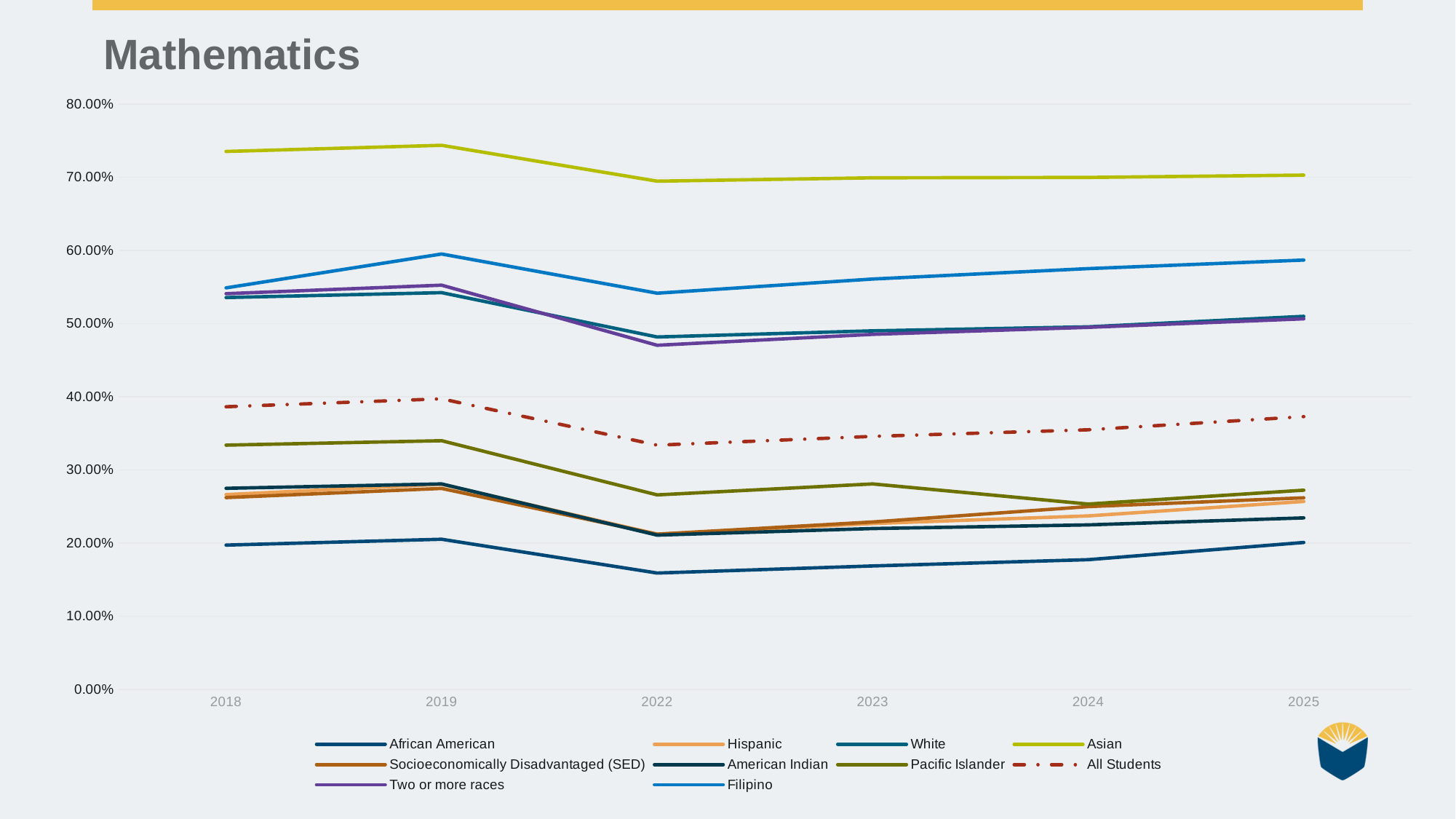
Is the value for African American in 2022 greater or less than 20%? less Is the value for All Students in 2022 greater or less than 40%? less Which series has the lowest value in 2022? African American Is the value for Pacific Islander in 2018 greater or less than 30%? greater What kind of chart is shown on the slide? line chart Which is larger in 2019, the value for Filipino or the value for White? Filipino Which series is drawn with a dashed line? All Students How many years are shown on the x axis? 6 Does the Asian line rise or fall from 2019 to 2022? fall Which series has the highest value in 2025? Asian How many series does the legend list? 10